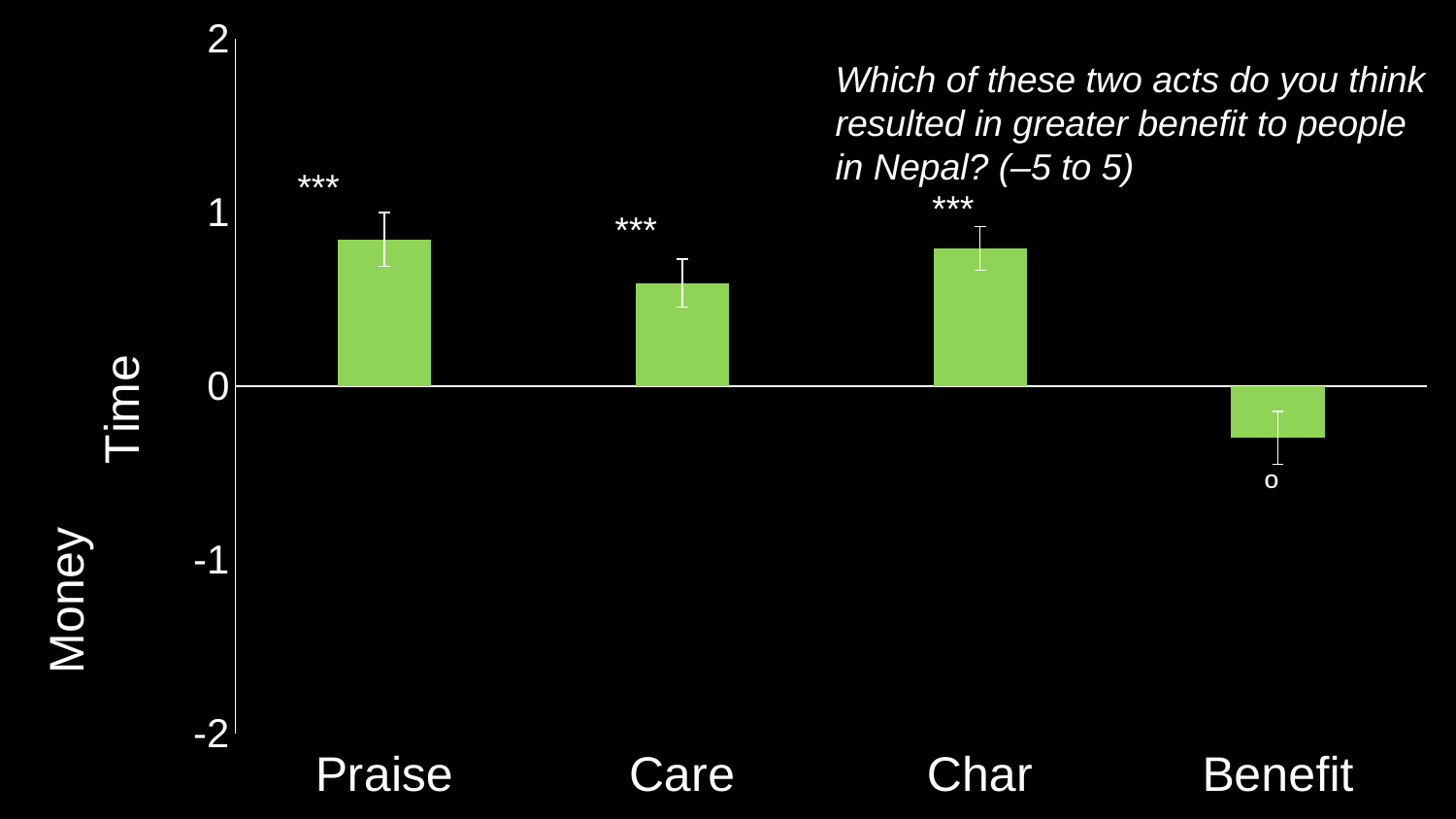
What is the range of the response scale mentioned in the question text on the slide? –5 to 5 Which is larger, the value for Praise or the value for Care? Praise Is the value for Benefit greater or less than -1? greater Which category has the lowest value? Benefit Is the value for Praise greater or less than 1? less Is the value for Benefit greater or less than 0? less What colour are the bars in the chart? green Which is larger, the value for Char or the value for Care? Char How many categories have a negative value? 1 What kind of chart is shown on the slide? bar chart How many categories are shown on the x axis? 4